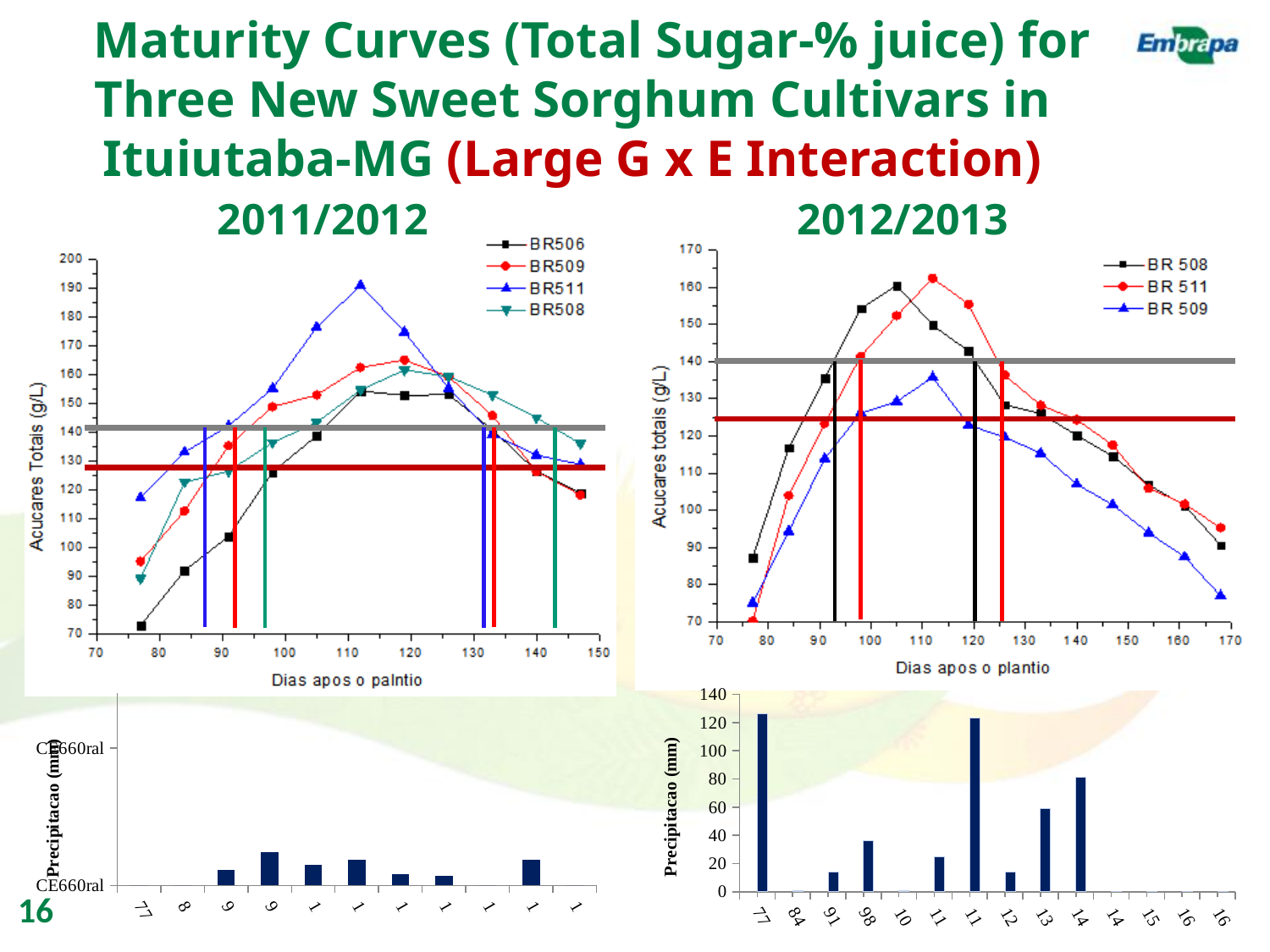
In the 2011/2012 chart, at day 112, which series has the larger value, BR511 or BR509? BR511 What kind of chart is the 2011/2012 chart at the top left? line chart In the 2012/2013 chart, which series has the lowest peak value? BR 509 How many series does the legend of the 2012/2013 chart list? 3 In the 2012/2013 precipitation bar chart at the bottom right, is the bar at 77 greater or less than 120? greater In the 2011/2012 chart, which series reaches the highest peak value? BR511 In the 2012/2013 chart, is the peak value of BR 509 greater or less than 140? less In the 2011/2012 chart, is the value of BR506 at day 77 greater or less than 80? less What is the y-axis label of the 2012/2013 line chart? Acucares totais (g/L) How many series does the legend of the 2011/2012 chart list? 4 In the 2012/2013 chart, does the BR 508 series rise or fall from day 105 to day 168? fall